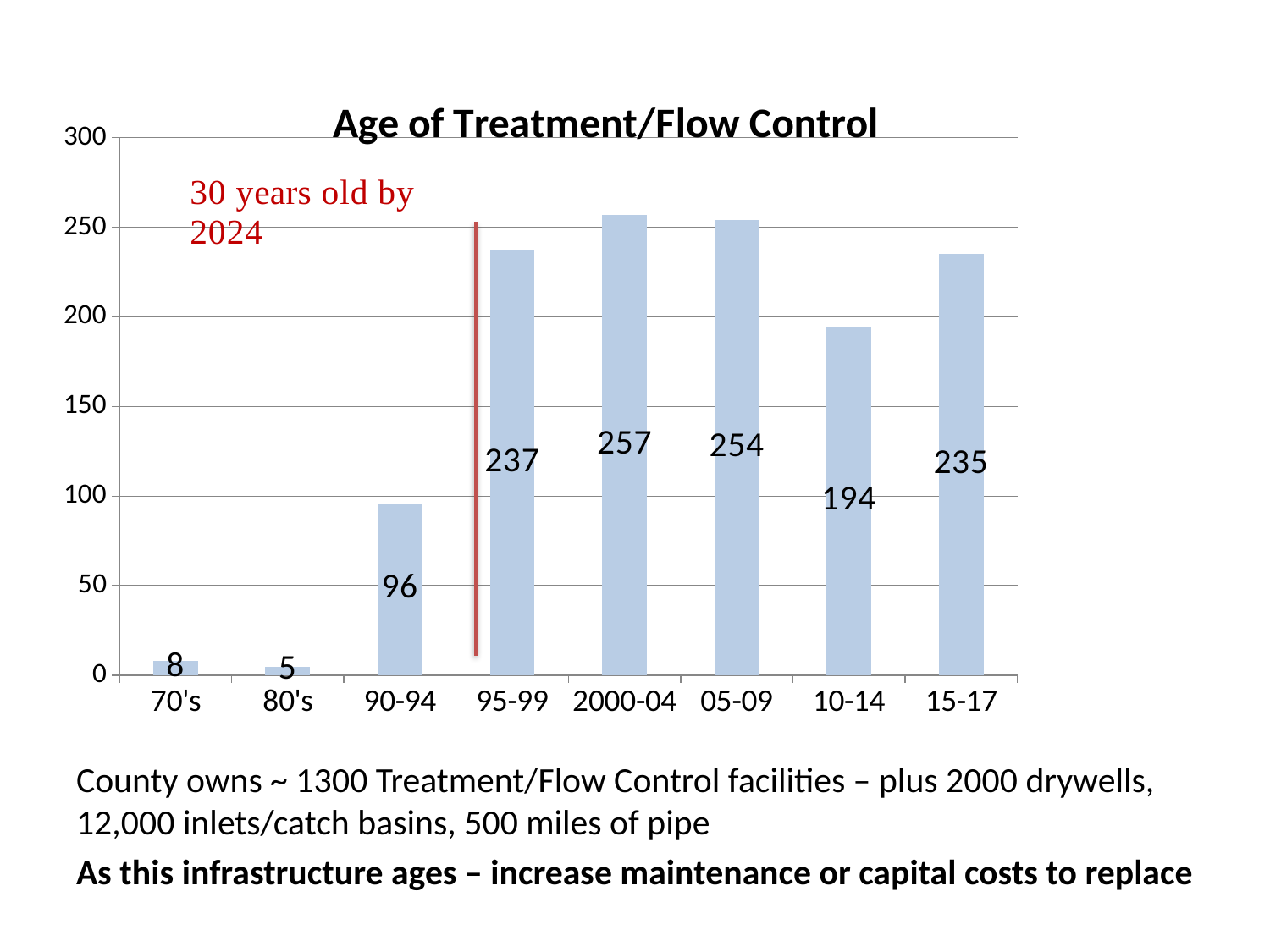
How many categories are shown on the x axis? 8 Which category has the lowest value? 80's What is the value for 10-14? 194 What is the difference between the values for 2000-04 and 10-14? 63 What is the title of the chart? Age of Treatment/Flow Control What kind of chart is this? bar chart Is the value for 90-94 greater or less than 100? less What does the red text next to the vertical red line say? 30 years old by 2024 What is the value for 95-99? 237 Which is larger, the value for 05-09 or the value for 15-17? 05-09 Which category has the highest value? 2000-04 What is the value for 90-94? 96